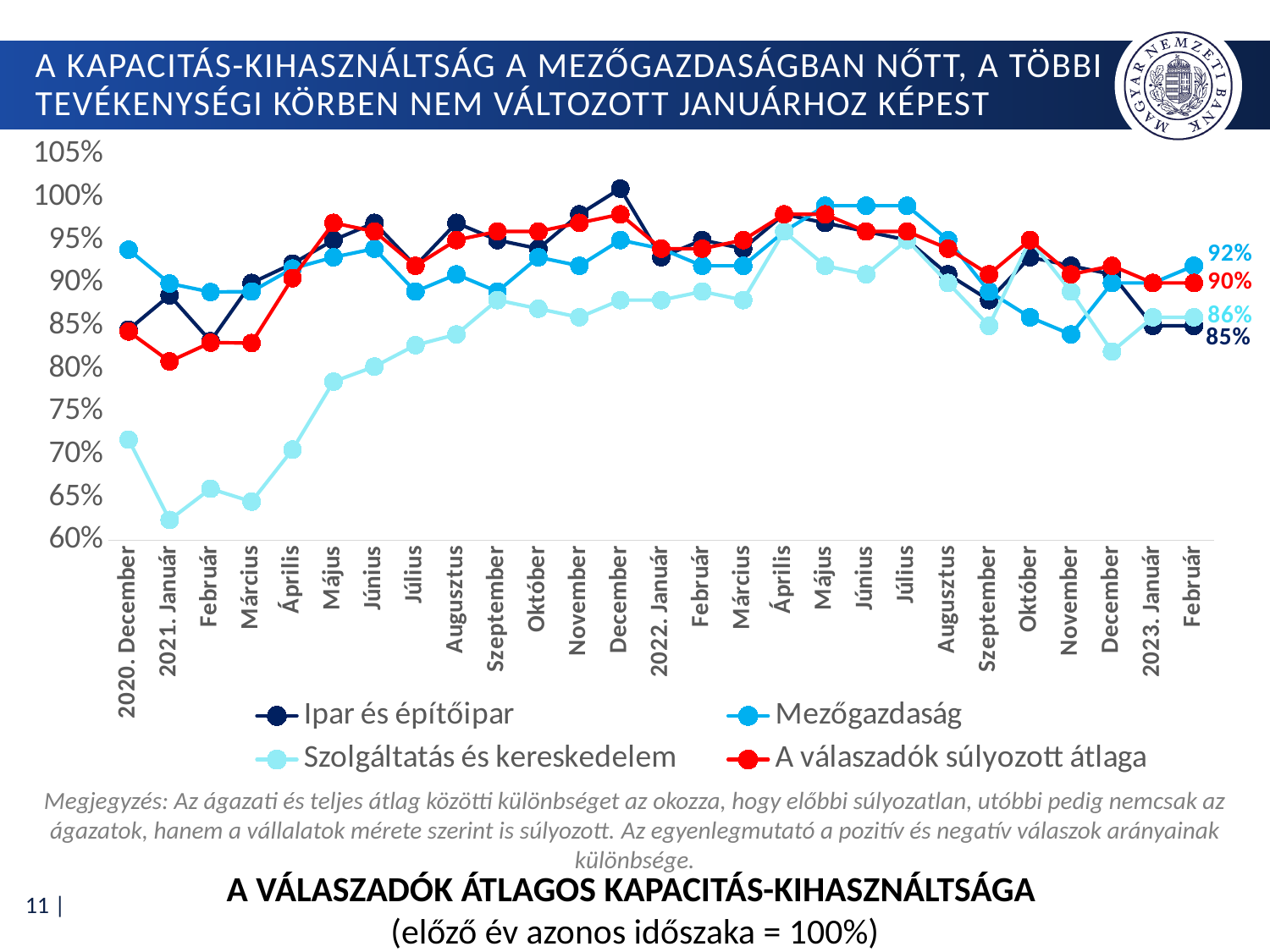
Which series has the lowest value in 2021. Január? Szolgáltatás és kereskedelem In Február 2023, which is larger: Mezőgazdaság or A válaszadók súlyozott átlaga? Mezőgazdaság What kind of chart is shown on the slide? line chart How many series does the legend list? 4 What is the value for A válaszadók súlyozott átlaga in Február 2023? 90% How many months are shown on the x axis? 27 In Február 2023, how many percentage points higher is Mezőgazdaság than Ipar és építőipar? 7 percentage points Is the value for Szolgáltatás és kereskedelem in 2021. Január greater or less than 65%? less What is the value for Mezőgazdaság in Február 2023? 92% What is the value for Szolgáltatás és kereskedelem in Február 2023? 86% Does the Szolgáltatás és kereskedelem series rise or fall from 2021. Január to Május 2021? rise What is the value for Ipar és építőipar in Február 2023? 85%